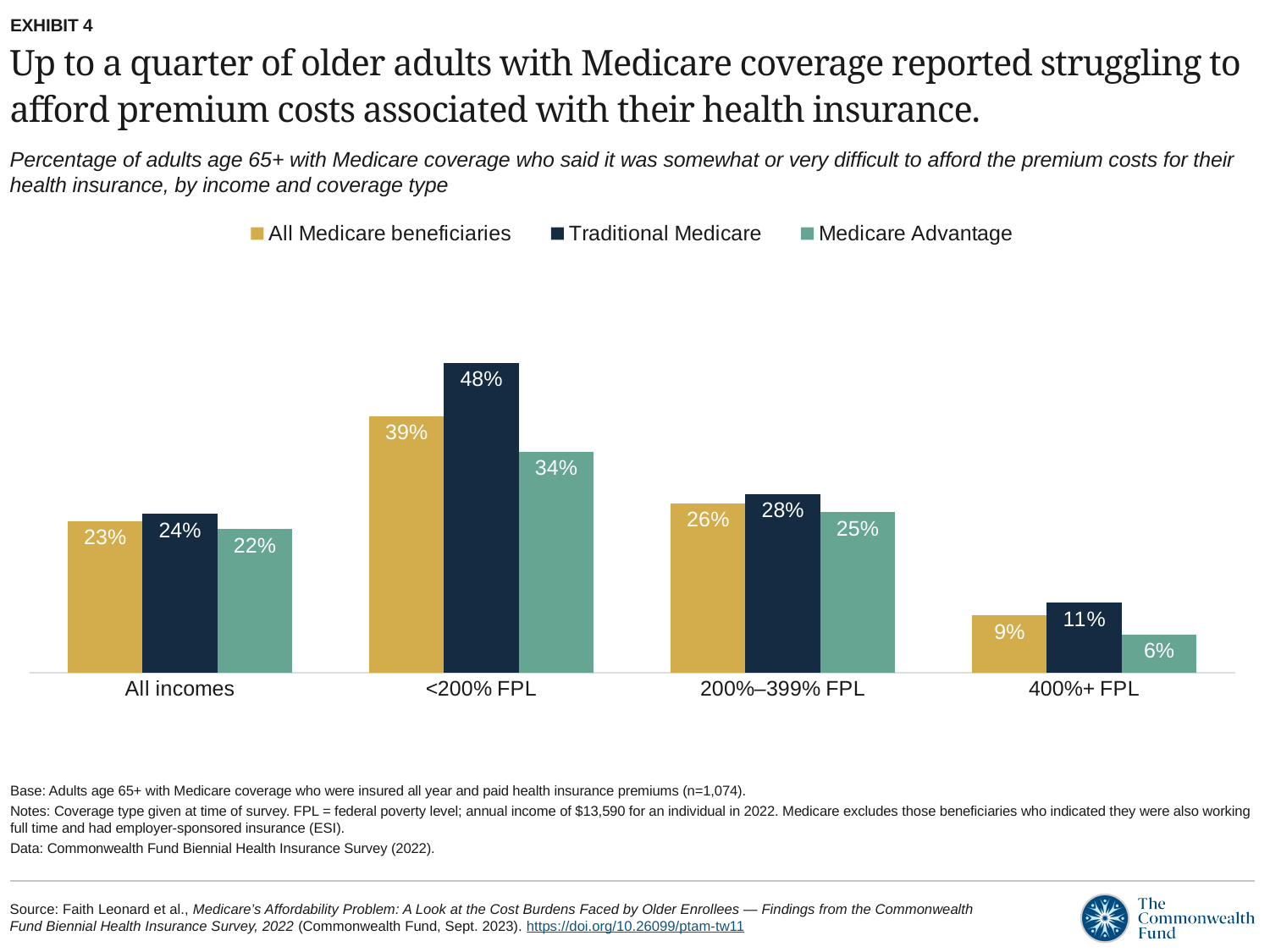
What kind of chart is shown on the slide? Bar chart Which income group has the highest value for Traditional Medicare? <200% FPL In the 200%–399% FPL group, which is larger: Traditional Medicare or Medicare Advantage? Traditional Medicare Which income group has the lowest value for All Medicare beneficiaries? 400%+ FPL What percentage of Traditional Medicare beneficiaries with income below 200% FPL said it was difficult to afford premium costs? 48% How many income categories are shown on the x axis? 4 What is the difference between the Traditional Medicare and Medicare Advantage values in the 400%+ FPL group? 5 percentage points What is the value for Medicare Advantage in the 400%+ FPL group? 6% What is the difference between the Traditional Medicare and Medicare Advantage values in the <200% FPL group? 14 percentage points What is the value for All Medicare beneficiaries in the 200%–399% FPL group? 26% How many series does the legend list? 3 Which series is shown in dark navy in the legend? Traditional Medicare